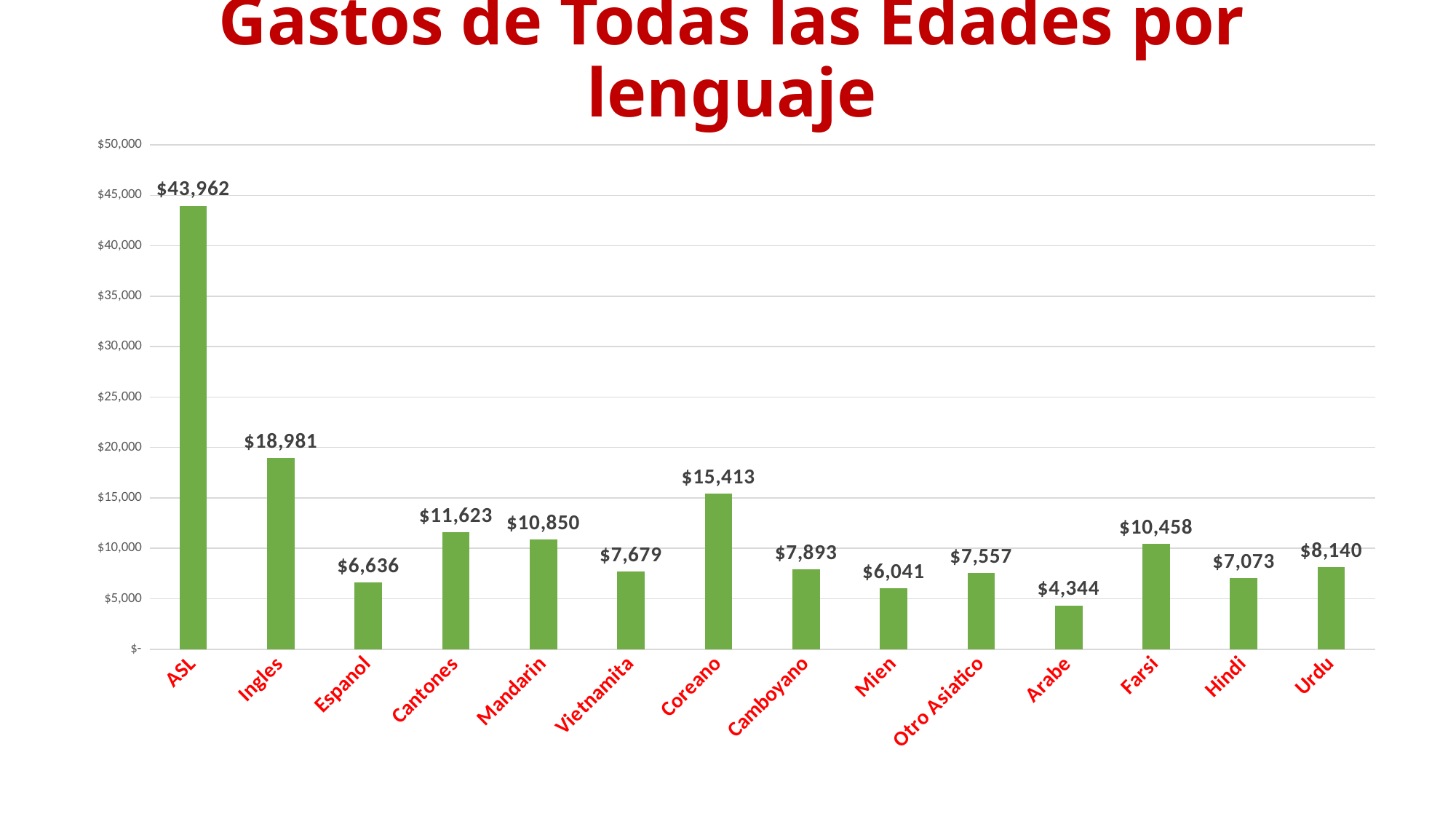
What is the value for Coreano? $15,413 How many languages are shown on the x axis? 14 What is the title of the chart? Gastos de Todas las Edades por lenguaje Which is larger, the value for Coreano or the value for Cantones? Coreano Is the value for Ingles greater or less than $15,000? greater Which language has the lowest value? Arabe What is the difference between the values for ASL and Ingles? $24,981 What kind of chart is shown on the slide? Bar chart Which language has the highest value? ASL What is the value for ASL? $43,962 What is the difference between the values for Cantones and Mandarin? $773 What is the value for Farsi? $10,458